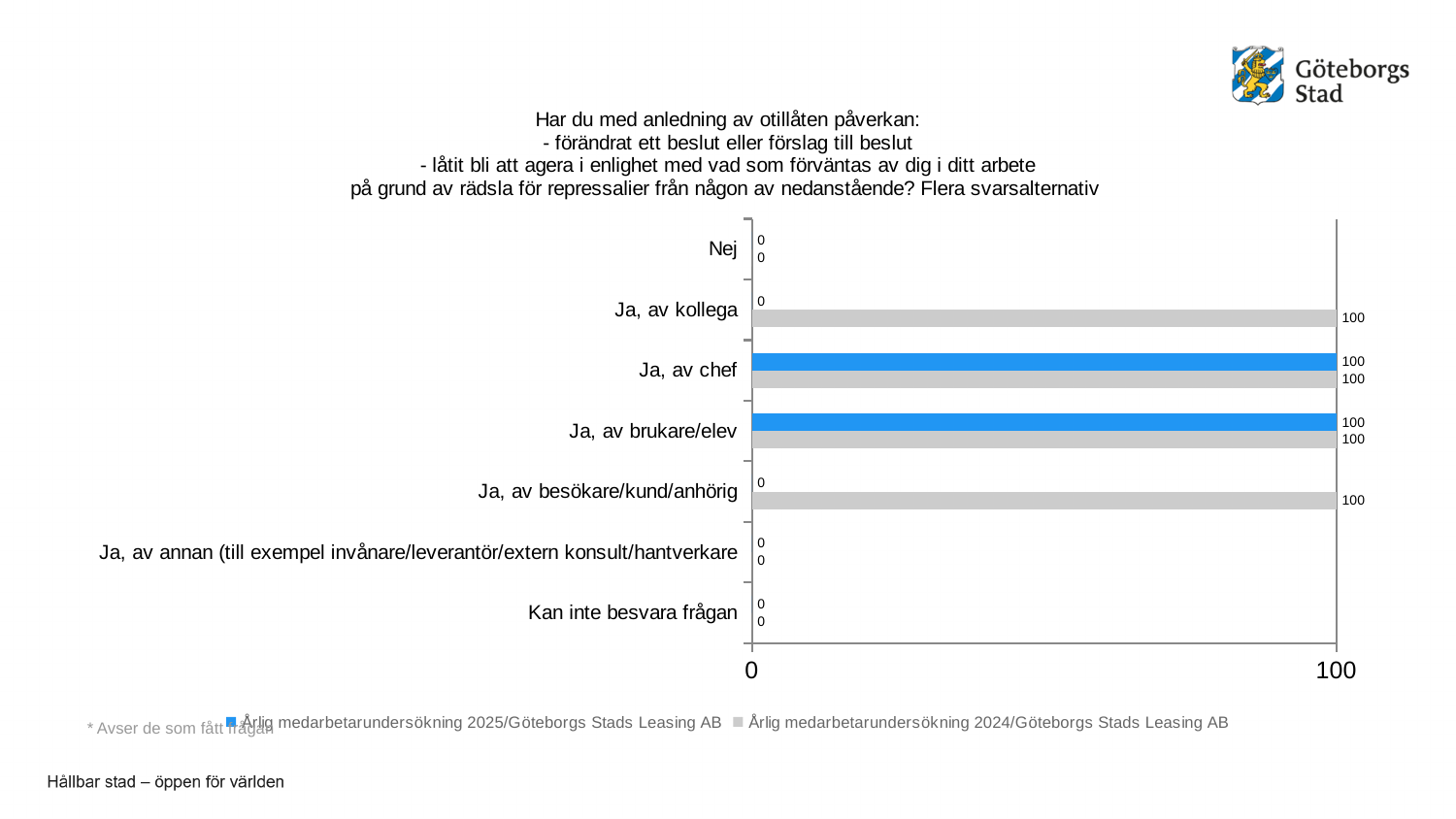
Which is larger for "Ja, av kollega": the 2025 value or the 2024 value? the 2024 value How many categories are listed on the vertical axis of the chart? 7 What is the value for "Ja, av chef" in the Årlig medarbetarundersökning 2025/Göteborgs Stads Leasing AB series? 100 What is the value for "Ja, av besökare/kund/anhörig" in the Årlig medarbetarundersökning 2024/Göteborgs Stads Leasing AB series? 100 How many series does the chart legend list? 2 What is the value for "Ja, av kollega" in the Årlig medarbetarundersökning 2025/Göteborgs Stads Leasing AB series? 0 What is the value for "Ja, av brukare/elev" in the Årlig medarbetarundersökning 2024/Göteborgs Stads Leasing AB series? 100 What type of chart is shown on the slide? bar chart What is the value for "Nej" in the Årlig medarbetarundersökning 2025/Göteborgs Stads Leasing AB series? 0 What is the value for "Ja, av kollega" in the Årlig medarbetarundersökning 2024/Göteborgs Stads Leasing AB series? 100 What is the difference between the 2024 and 2025 values for "Ja, av besökare/kund/anhörig"? 100 Which colour represents the Årlig medarbetarundersökning 2025/Göteborgs Stads Leasing AB series in the chart? blue